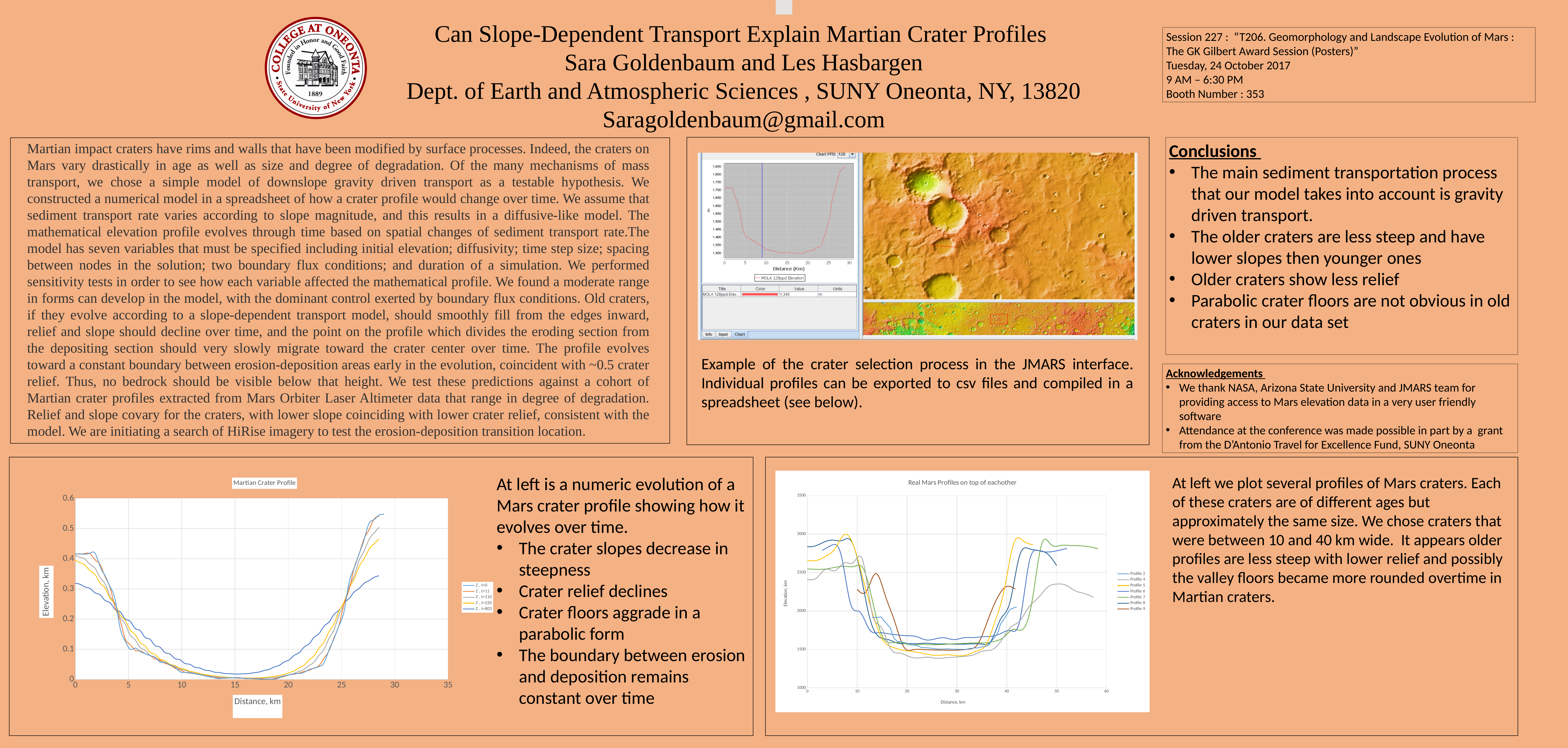
What kind of chart is the "Martian Crater Profile" chart at the bottom left? line chart In the "Martian Crater Profile" chart, is the elevation at a distance of 15 km greater or less than 0.1? less In the "Martian Crater Profile" chart, do the elevation values rise or fall as distance increases from 0 to 15 km? fall In the "Martian Crater Profile" chart, do the elevation values rise or fall as distance increases from 20 to 28 km? rise What kind of chart is the "Real Mars Profiles on top of eachother" chart at the bottom right? line chart What is the title of the line chart at the bottom right of the slide? Real Mars Profiles on top of eachother In the "Real Mars Profiles on top of eachother" chart, are the elevation values at a distance of 0 km greater or less than 2000? greater How many series does the legend of the "Real Mars Profiles on top of eachother" chart list? 7 In the "Real Mars Profiles on top of eachother" chart, are the elevation values at a distance of 25 km greater or less than 2000? less In the JMARS interface chart at the top centre, what value is listed in the table for MOLA 128ppd Elev.? 1,345 What is the x-axis label of the "Martian Crater Profile" chart? Distance, km How many series does the legend of the "Martian Crater Profile" chart list? 5